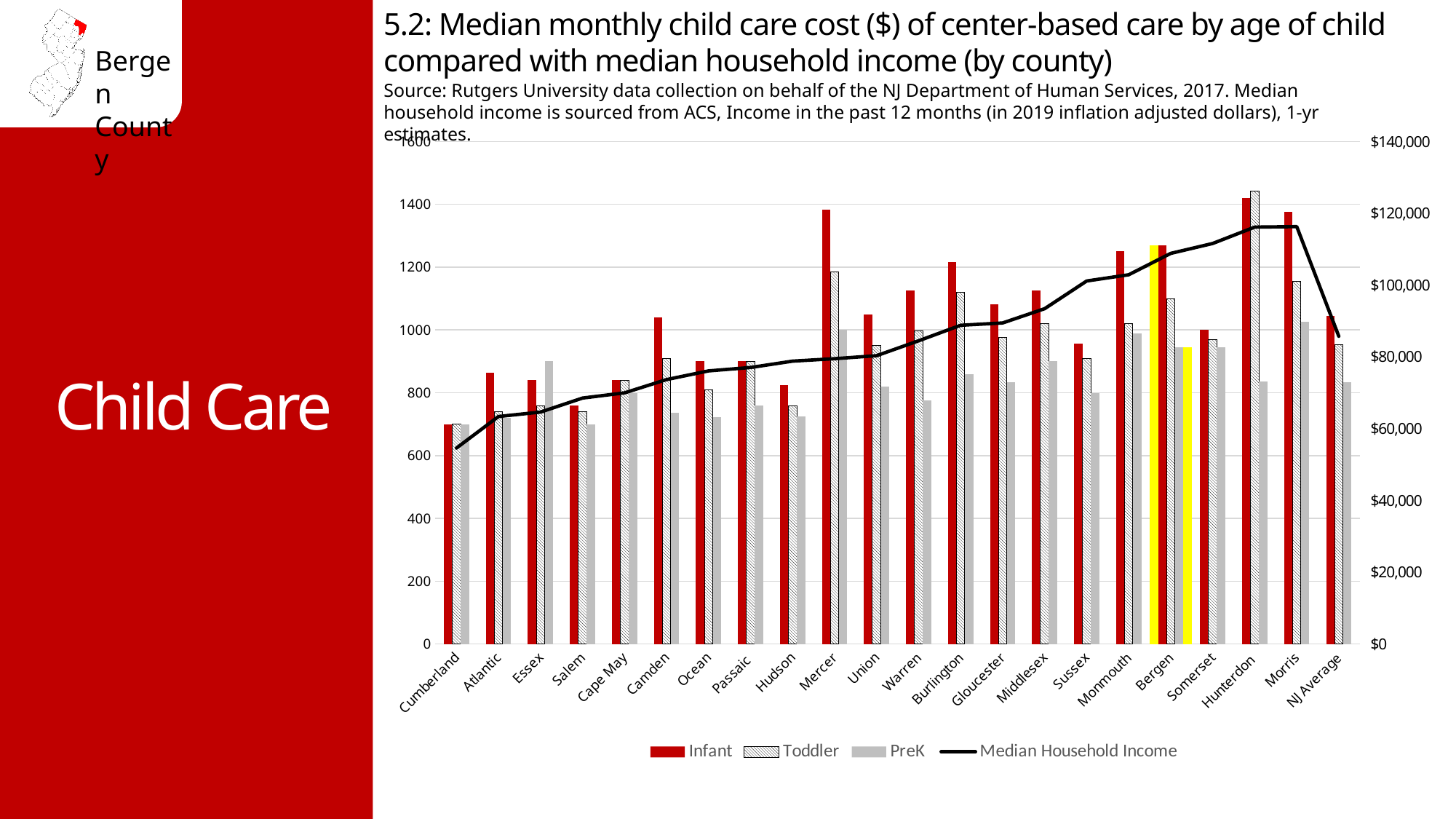
Which category has the highest Toddler bar? Hunterdon What kind of chart is shown on the slide? Bar chart with a line Is the PreK value for Essex greater or less than 800? greater Is the Infant value for Mercer greater or less than 1200? greater Which category has the lowest Infant bar? Cumberland Which county's bars are highlighted in yellow? Bergen Does the Median Household Income line generally rise or fall from Cumberland to Morris? rise How many counties/categories are shown along the x axis? 22 Which is larger, the Infant value for Mercer or the Infant value for Cumberland? Mercer Is the Toddler value for Hunterdon greater or less than 1400? greater How many series does the legend list? 4